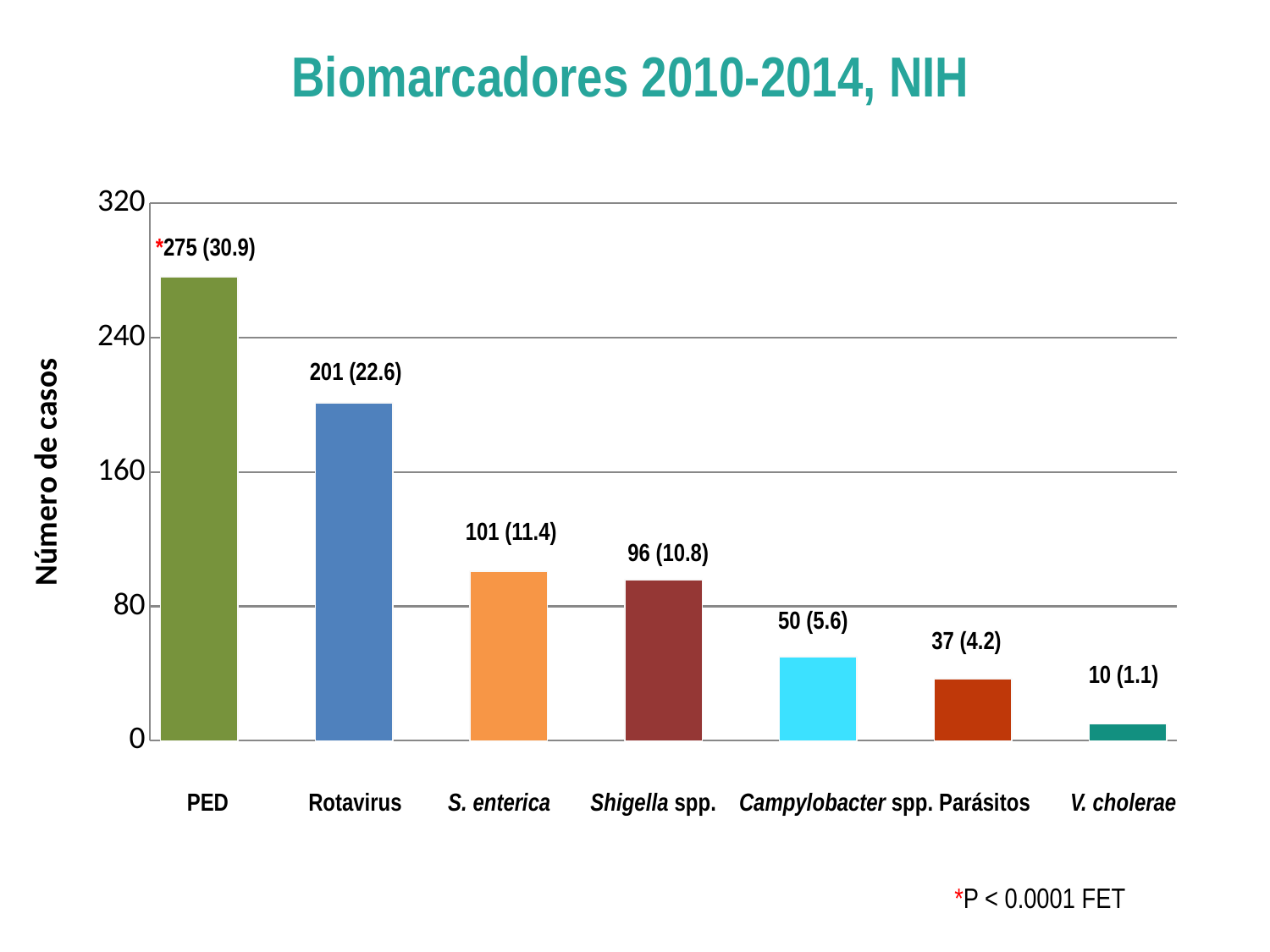
What kind of chart is shown on the slide? bar chart How many categories are shown on the x axis? 7 What is the number of cases for Rotavirus? 201 What is the difference in number of cases between S. enterica and Shigella spp.? 5 Which has more cases, Parásitos or Campylobacter spp.? Campylobacter spp. What is the title of the chart? Biomarcadores 2010-2014, NIH What is the number of cases for Campylobacter spp.? 50 Is the value for Rotavirus greater or less than 240? less Which category has the highest number of cases? PED Which category has the lowest number of cases? V. cholerae What data label is shown above the Shigella spp. bar? 96 (10.8) What is the difference in number of cases between PED and Rotavirus? 74